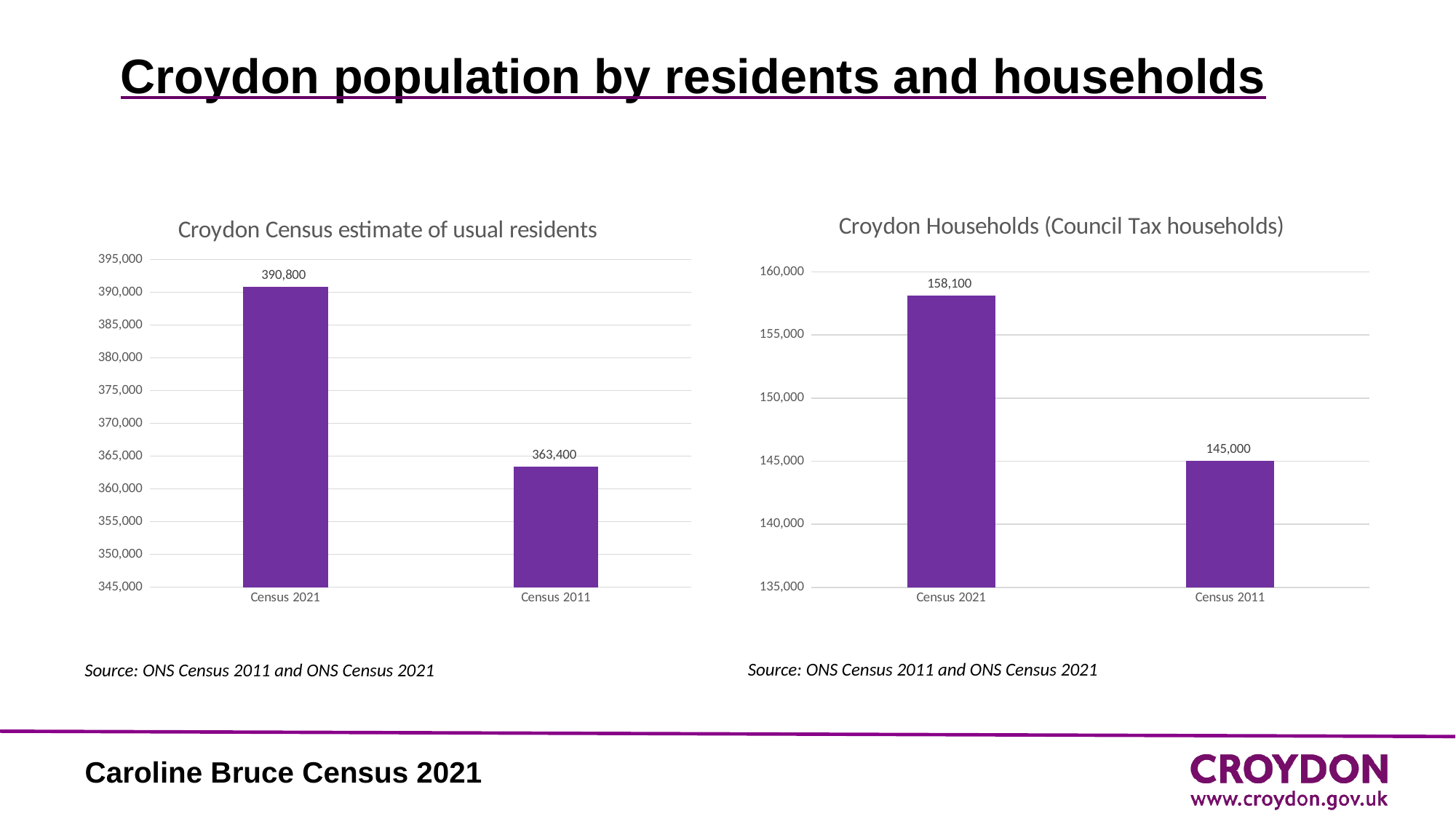
How many categories are shown in the 'Croydon Census estimate of usual residents' chart? 2 In the 'Croydon Census estimate of usual residents' chart, what is the difference between the Census 2021 and Census 2011 values? 27,400 In the 'Croydon Households (Council Tax households)' chart, what is the value for Census 2021? 158,100 In the 'Croydon Households (Council Tax households)' chart, which is larger: Census 2021 or Census 2011? Census 2021 In the 'Croydon Census estimate of usual residents' chart, what is the value for Census 2011? 363,400 What is the title of the chart on the left of the slide? Croydon Census estimate of usual residents In the 'Croydon Census estimate of usual residents' chart, which category has the highest value? Census 2021 In the 'Croydon Census estimate of usual residents' chart, what is the value for Census 2021? 390,800 In the 'Croydon Households (Council Tax households)' chart, which category has the lowest value? Census 2011 In the 'Croydon Households (Council Tax households)' chart, what is the difference between the Census 2021 and Census 2011 values? 13,100 In the 'Croydon Households (Council Tax households)' chart, what is the value for Census 2011? 145,000 What kind of chart is the 'Croydon Households (Council Tax households)' chart? Bar chart